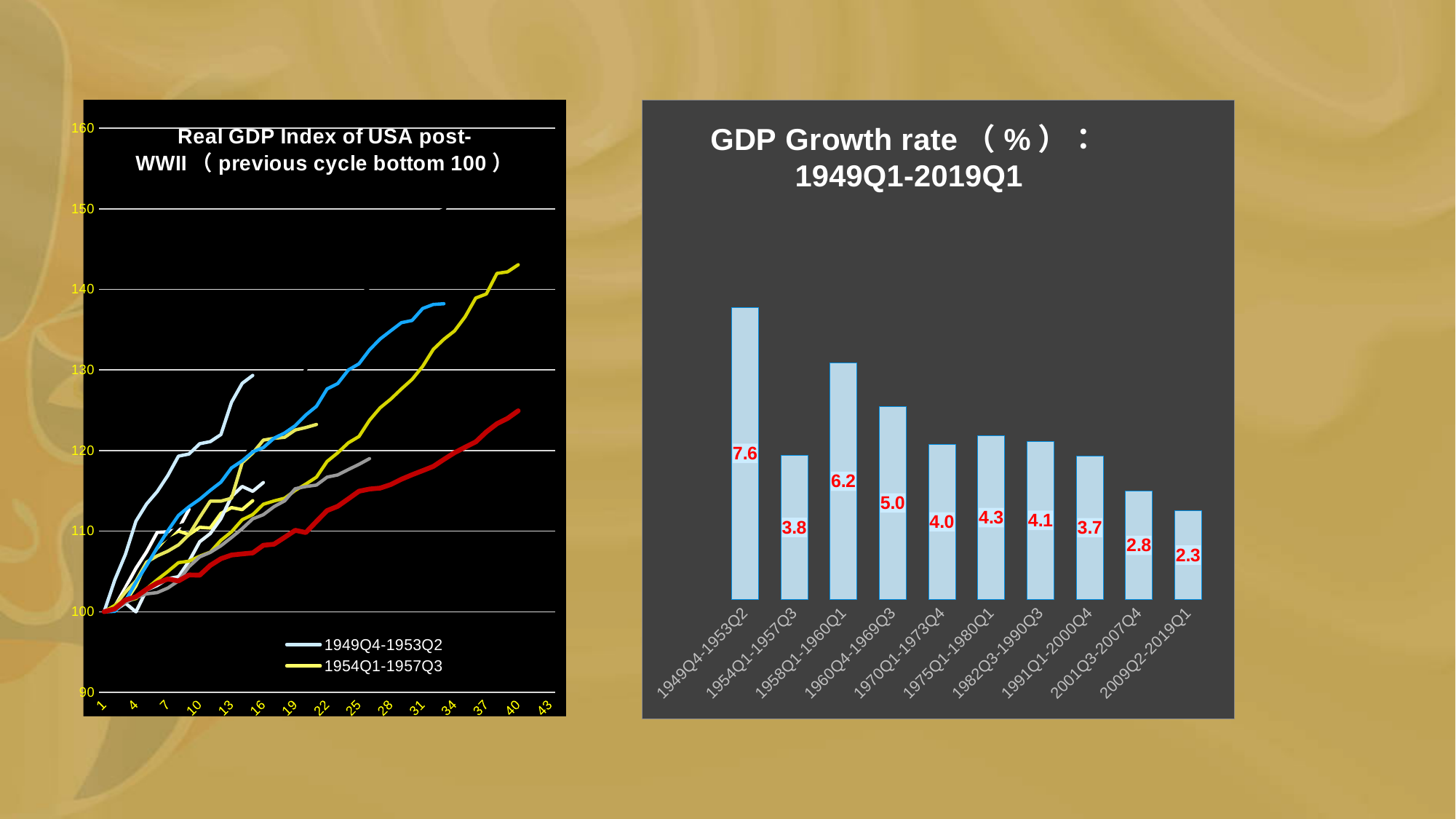
On the GDP Growth rate chart, what is the difference between the values for 1958Q1-1960Q1 and 1960Q4-1969Q3? 1.2 On the GDP Growth rate chart, which is larger: the value for 1975Q1-1980Q1 or the value for 1991Q1-2000Q4? 1975Q1-1980Q1 On the GDP Growth rate chart, which period has the lowest growth rate? 2009Q2-2019Q1 On the GDP Growth rate chart, which period has the highest growth rate? 1949Q4-1953Q2 How many series does the legend of the Real GDP Index chart on the left list? 2 What kind of chart is the Real GDP Index chart on the left? Line chart What kind of chart is the GDP Growth rate chart on the right? Bar chart How many bars are shown on the GDP Growth rate chart? 10 On the GDP Growth rate chart, what is the value for 1982Q3-1990Q3? 4.1 On the GDP Growth rate chart, what is the value for 1949Q4-1953Q2? 7.6 On the GDP Growth rate chart, what is the value for 2009Q2-2019Q1? 2.3 On the GDP Growth rate chart, what is the difference between the values for 2001Q3-2007Q4 and 2009Q2-2019Q1? 0.5